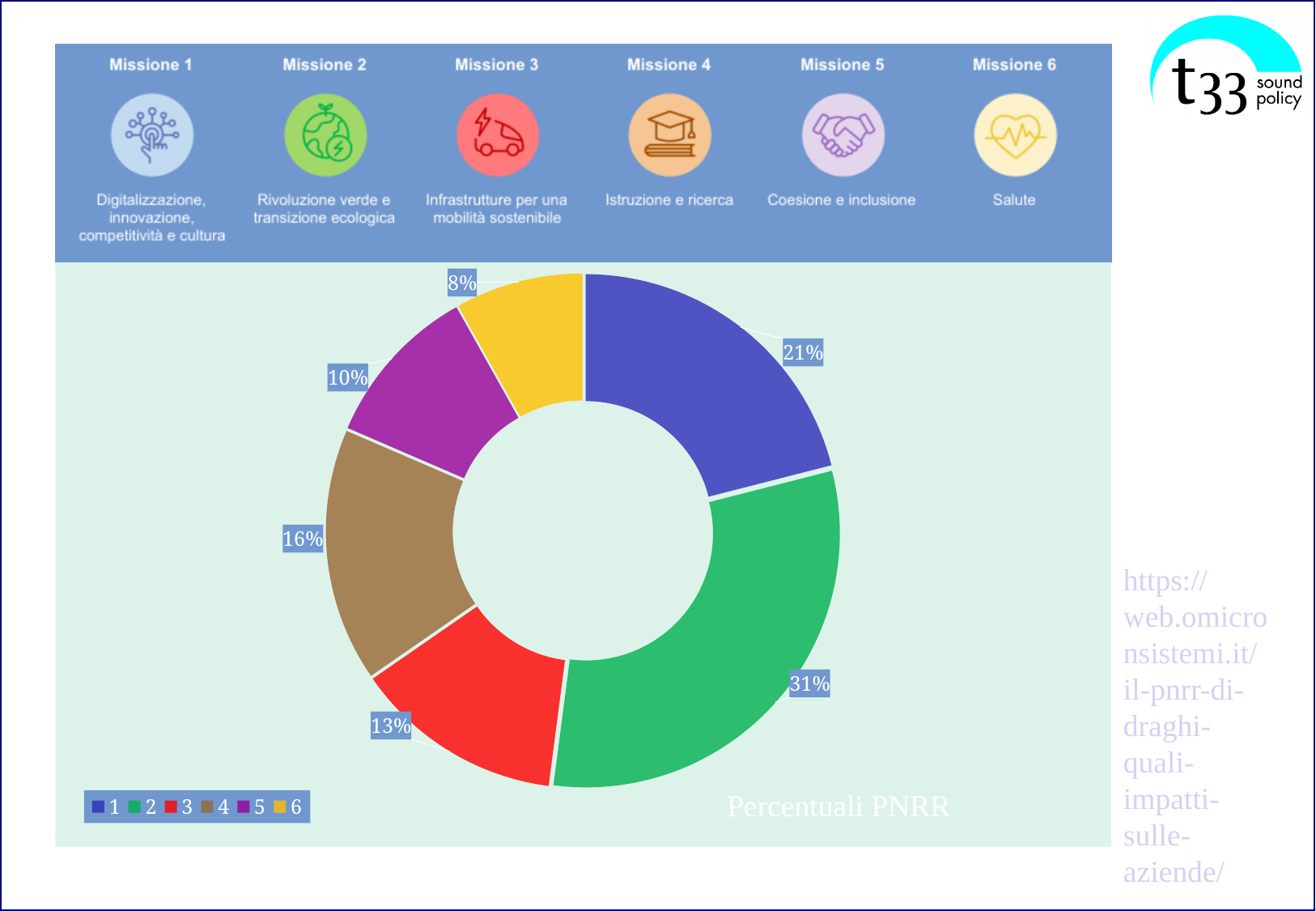
What is the value shown for category 1 in the doughnut chart? 21% What colour is used for category 5 in the chart? purple What percentage is shown for category 4? 16% Which category has the smallest share in the chart? 6 What is the title of the chart? Percentuali PNRR What is the difference in percentage points between category 2 and category 1? 10 What kind of chart is shown on the slide? doughnut chart What percentage is shown for category 6? 8% Which is larger, the share for category 3 or the share for category 5? 3 Which category has the largest share in the chart? 2 How many categories does the chart show? 6 What share of the doughnut chart does category 2 represent? 31%